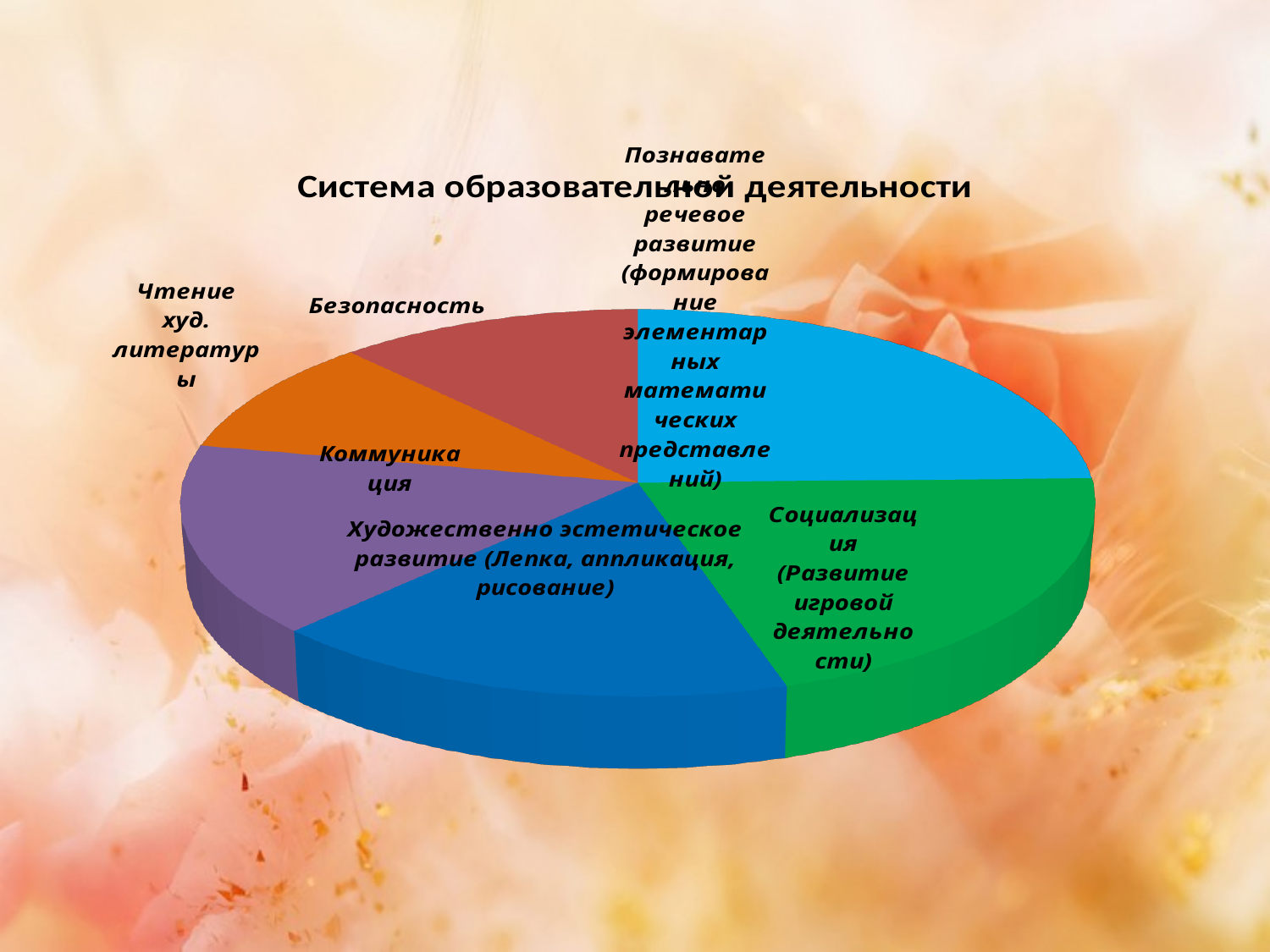
Which slice is larger: Социализация or Безопасность? Социализация Which slice is larger: Познавательно-речевое развитие or Чтение худ. литературы? Познавательно-речевое развитие Which slice is larger: Художественно эстетическое развитие or Коммуникация? Художественно эстетическое развитие What is the title of the chart? Система образовательной деятельности How many slices does the pie chart have? 6 What kind of chart is shown on the slide? Pie chart What colour is the Социализация slice? Green